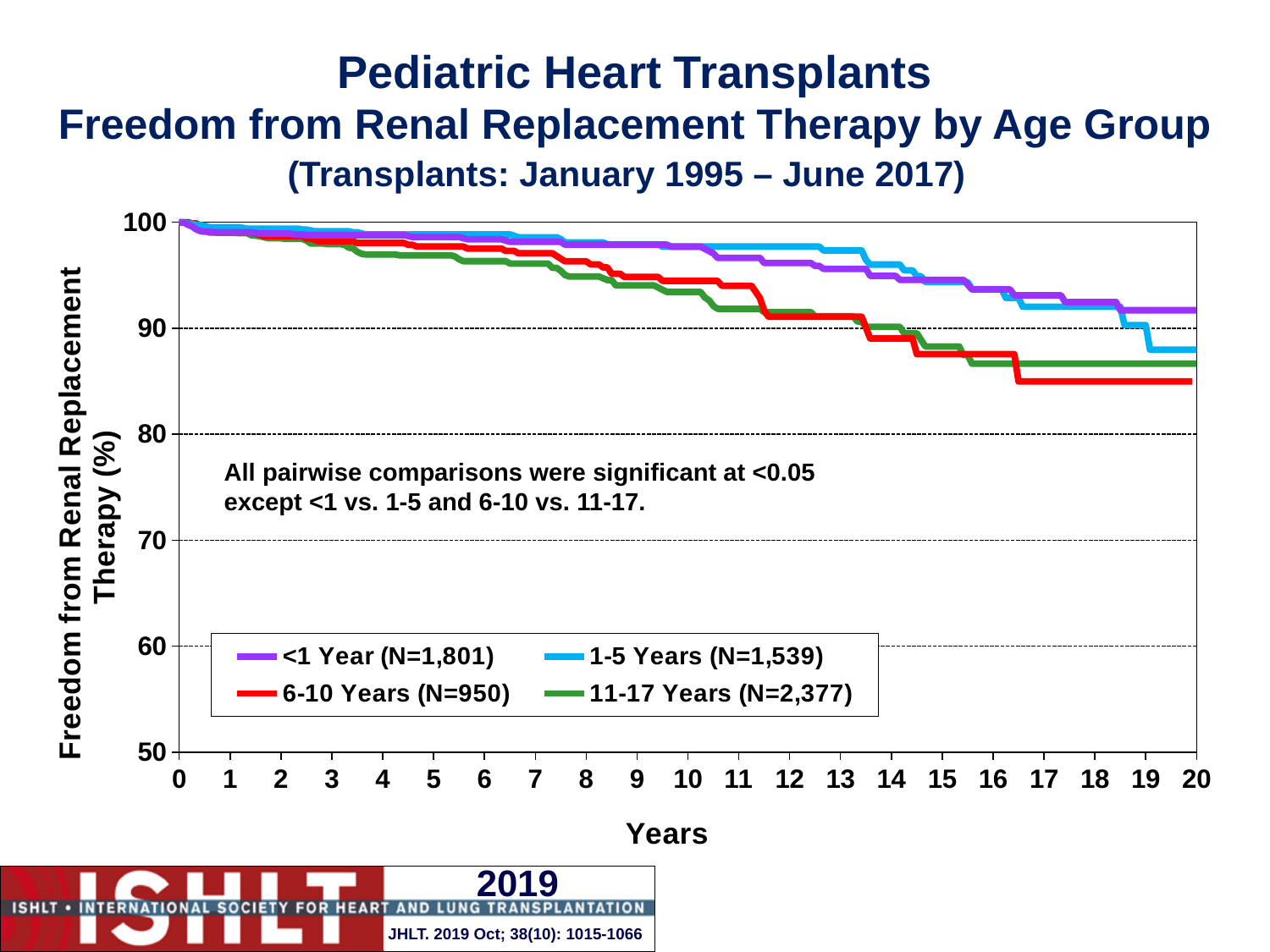
Is the value for the <1 Year group at 20 years greater or less than 90? greater What is the label of the x axis? Years Is the value for the 6-10 Years group at 20 years greater or less than 90? less Is the value for the 11-17 Years group at 10 years greater or less than 90? greater What kind of chart is shown on the slide? line chart How many series does the legend list? 4 What is the freedom from renal replacement therapy for all groups at year 0? 100 Do the values for each age group rise or fall as years increase? fall What is the sample size (N) shown in the legend for the 6-10 Years group? 950 Which age group has the smallest N in the legend? 6-10 Years (N=950) Which age group has the largest N in the legend? 11-17 Years (N=2,377) Which age group has the highest freedom from renal replacement therapy at 20 years? <1 Year